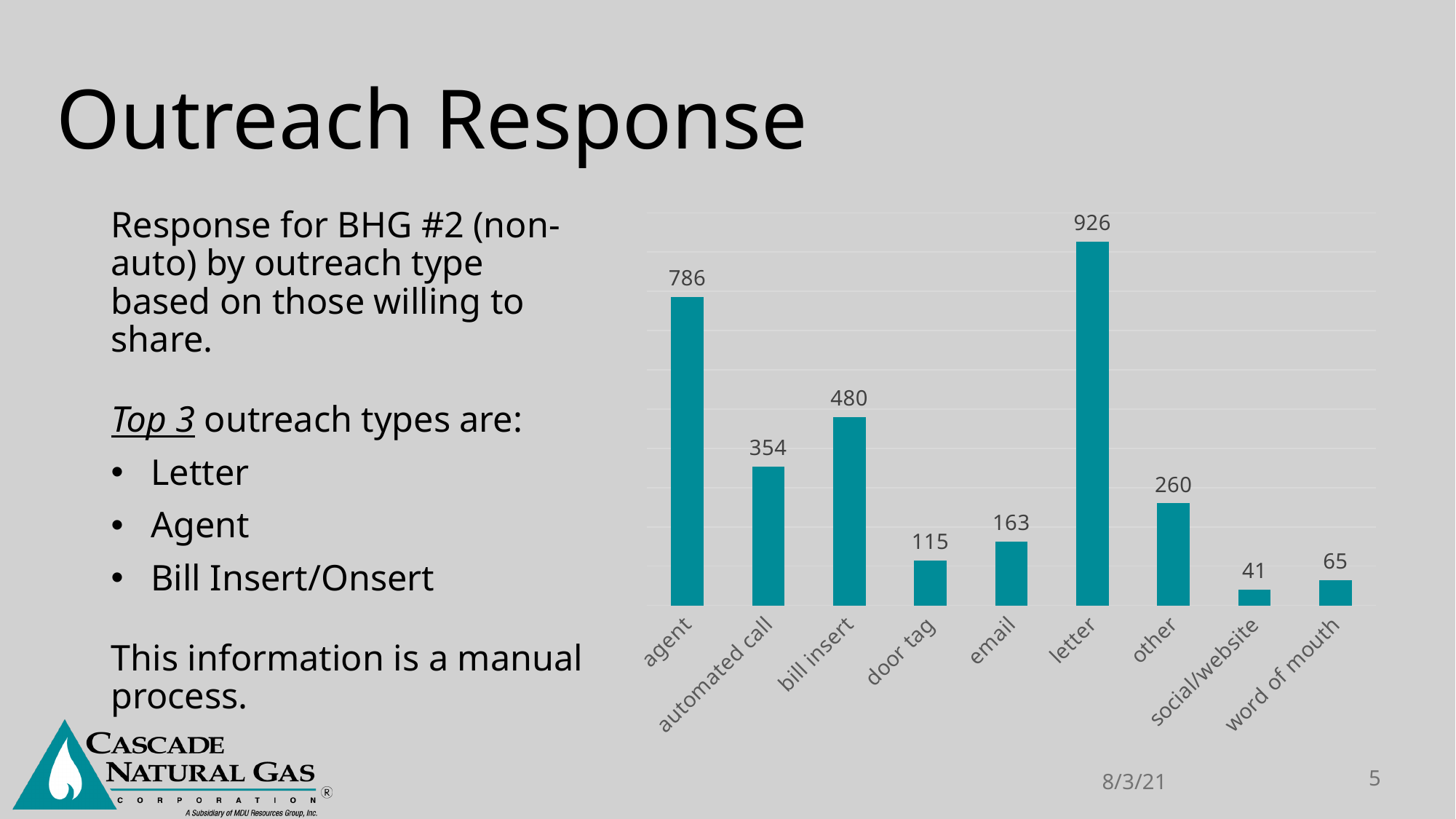
How many outreach types are shown on the x axis? 9 What is the value for door tag? 115 Which outreach type has the highest value? letter Which outreach type has the lowest value? social/website What is the difference between the values for bill insert and other? 220 What is the value for social/website? 41 What is the difference between the values for letter and agent? 140 Which is larger, the value for email or the value for word of mouth? email What is the value for automated call? 354 What colour are the bars in the chart? teal What kind of chart is shown on the slide? bar chart What is the value for letter? 926